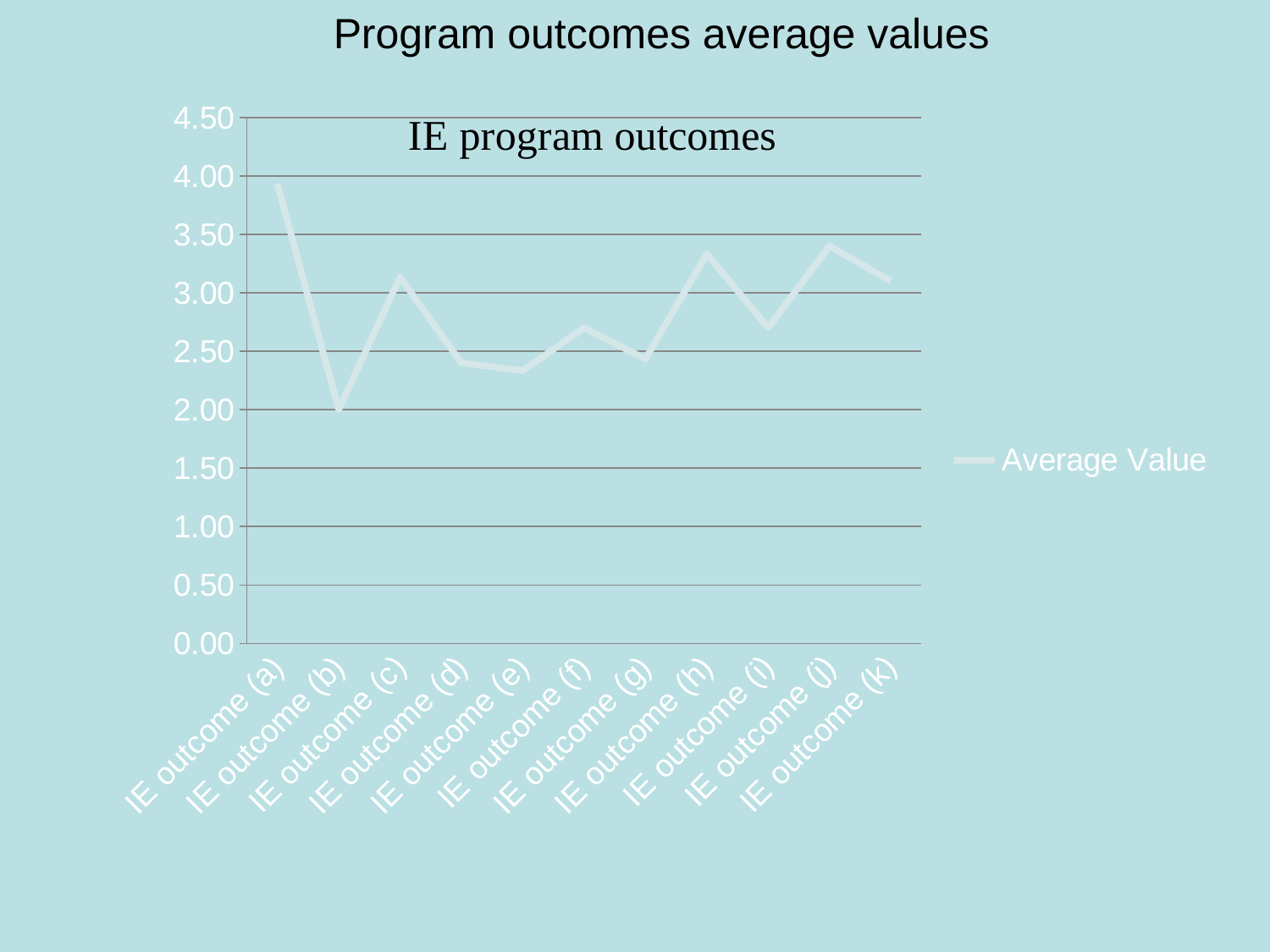
Is the value for IE outcome (a) greater or less than 3.50? greater Which has the larger average value, IE outcome (j) or IE outcome (i)? IE outcome (j) What is the title printed inside the chart area? IE program outcomes Is the value for IE outcome (e) greater or less than 2.50? less What is the name of the series shown in the legend? Average Value Is the value for IE outcome (h) greater or less than 3.00? greater Which IE outcome has the highest average value? IE outcome (a) Does the average value rise or fall from IE outcome (a) to IE outcome (b)? fall What kind of chart is shown on the slide? line chart How many series does the legend list? 1 Which IE outcome has the lowest average value? IE outcome (b) How many IE outcome categories are plotted along the x axis? 11